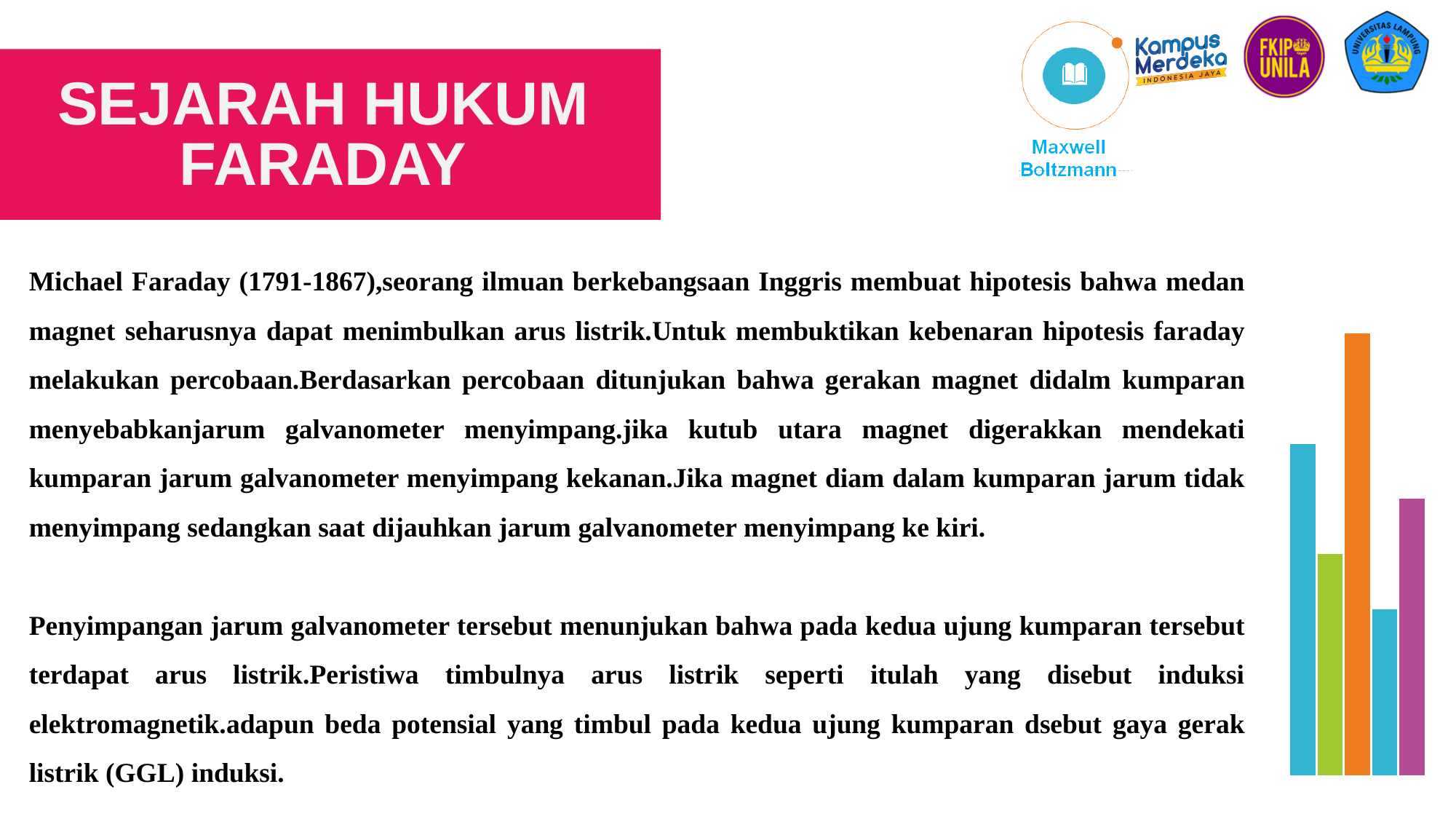
In the chart on the right side of the slide, which bar is the shortest? the fourth bar from the left (blue) How many bars does the chart on the right side of the slide have? 5 What colour is the tallest bar in the chart on the right side of the slide? orange In the chart on the right side of the slide, which bar is the tallest? the orange bar (third from left) In the chart on the right side of the slide, is the purple bar taller or shorter than the orange bar? shorter In the chart on the right side of the slide, is the first (blue) bar taller or shorter than the second (green) bar? taller What kind of chart is shown on the right side of the slide? bar chart Does the chart on the right side of the slide show any axis labels or data labels? No